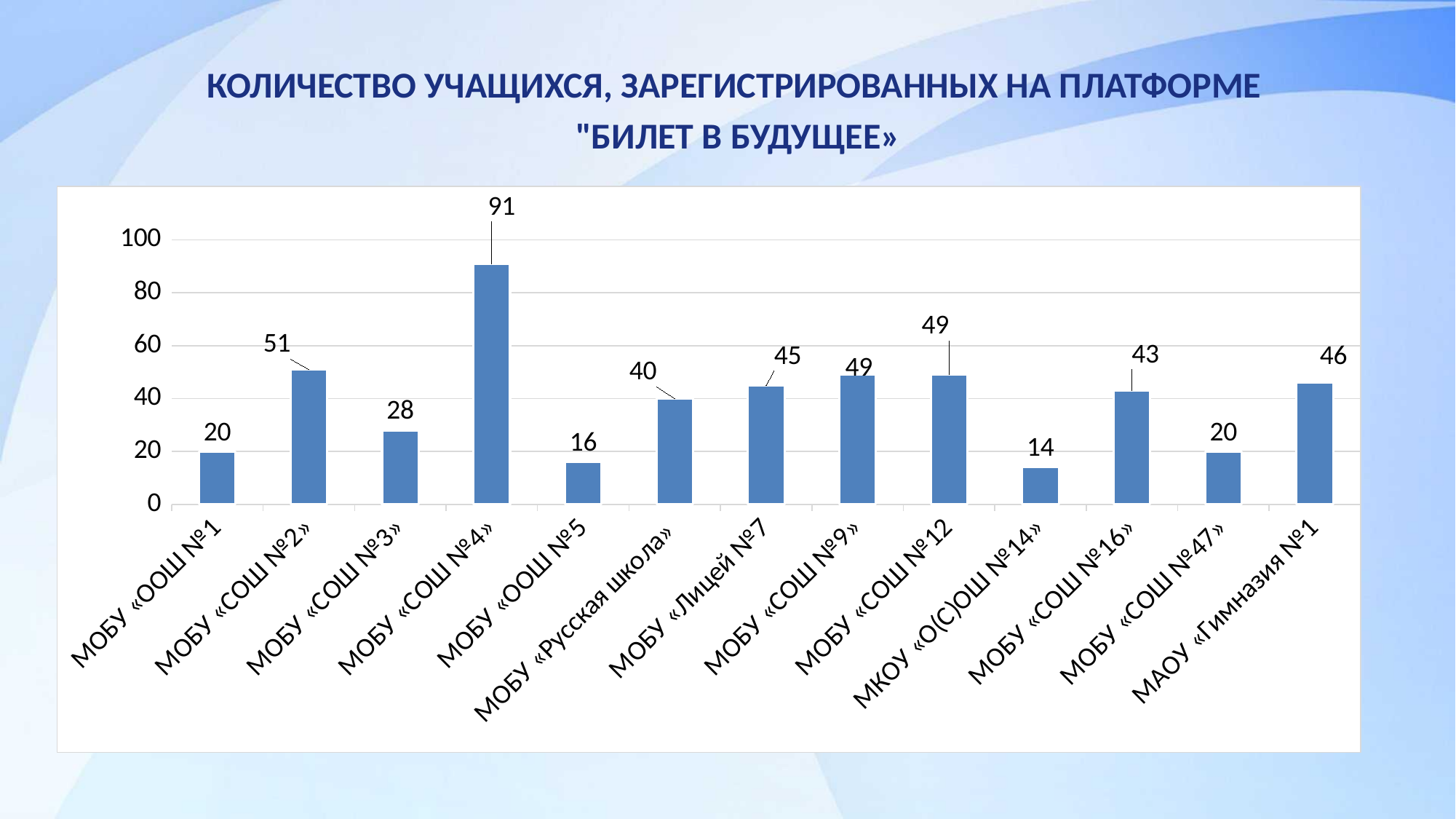
What kind of chart is shown on the slide? bar chart What is the title of the slide? КОЛИЧЕСТВО УЧАЩИХСЯ, ЗАРЕГИСТРИРОВАННЫХ НА ПЛАТФОРМЕ "БИЛЕТ В БУДУЩЕЕ» Which is larger, the value for МОБУ «СОШ №16» or the value for МОБУ «СОШ №3»? МОБУ «СОШ №16» Which category has the highest value? МОБУ «СОШ №4» What is the value for МОБУ «Лицей №7»? 45 Which category has the lowest value? МКОУ «О(С)ОШ №14» What is the difference between the values for МОБУ «СОШ №4» and МОБУ «СОШ №2»? 40 What is the value for МОБУ «Русская школа»? 40 Is the value for МОБУ «ООШ №5» greater or less than 20? less What is the value for МОБУ «СОШ №4»? 91 What is the value for МАОУ «Гимназия №1»? 46 How many categories are shown on the x axis? 13